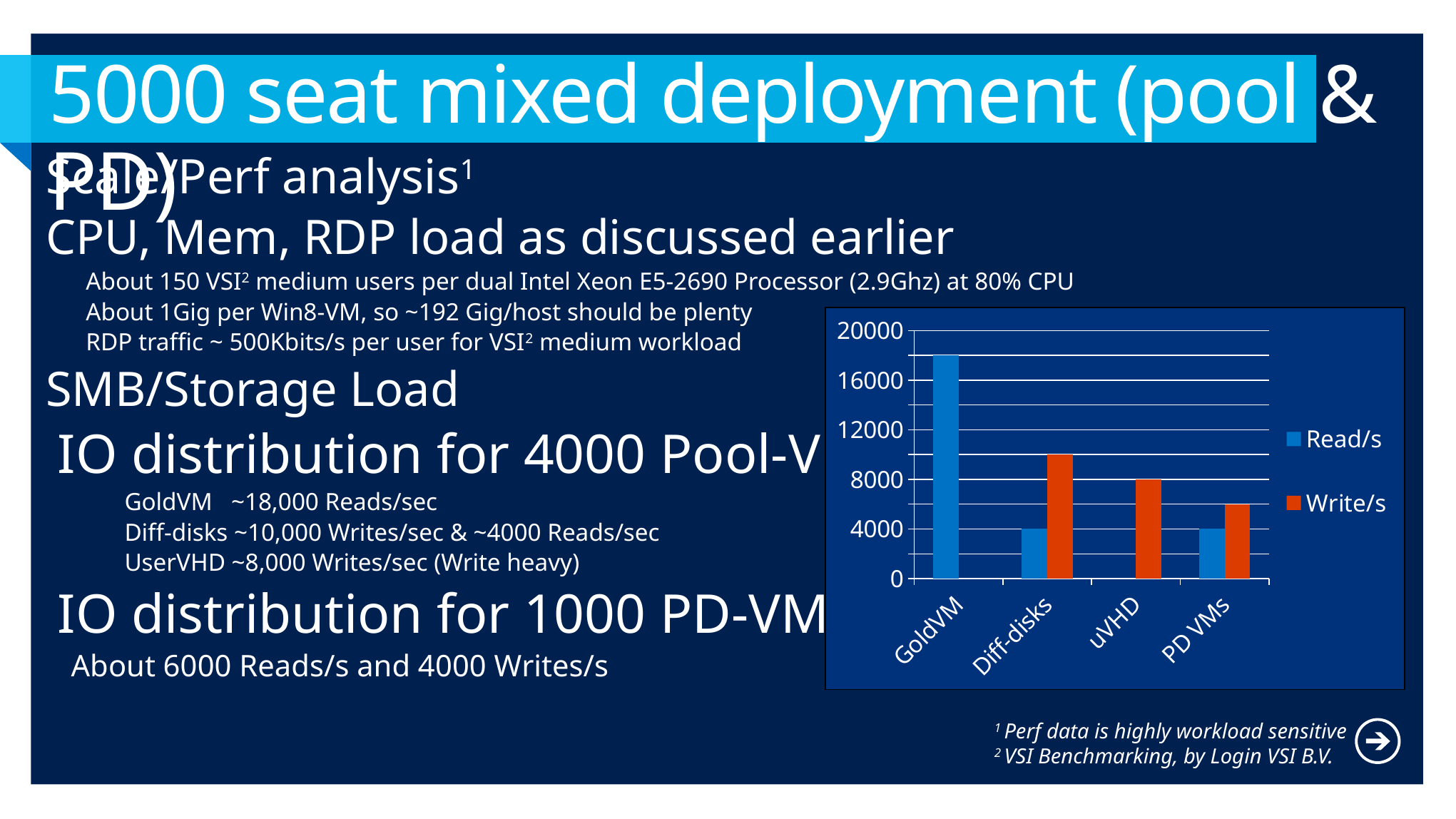
Which category has the highest Read/s value in the chart? GoldVM How many series does the chart legend list? 2 How many categories are shown on the x axis of the chart? 4 Which colour represents the Write/s series in the chart? orange What is the Write/s value for uVHD in the chart? 8000 What is the Read/s value for Diff-disks in the chart? 4000 Is the Write/s value for PD VMs greater or less than 8000? less What kind of chart is shown on the slide? bar chart Is the Read/s value for GoldVM greater or less than 16000? greater For Diff-disks, which is larger: Read/s or Write/s? Write/s Which category has the highest Write/s value in the chart? Diff-disks What is the Read/s value for PD VMs in the chart? 4000